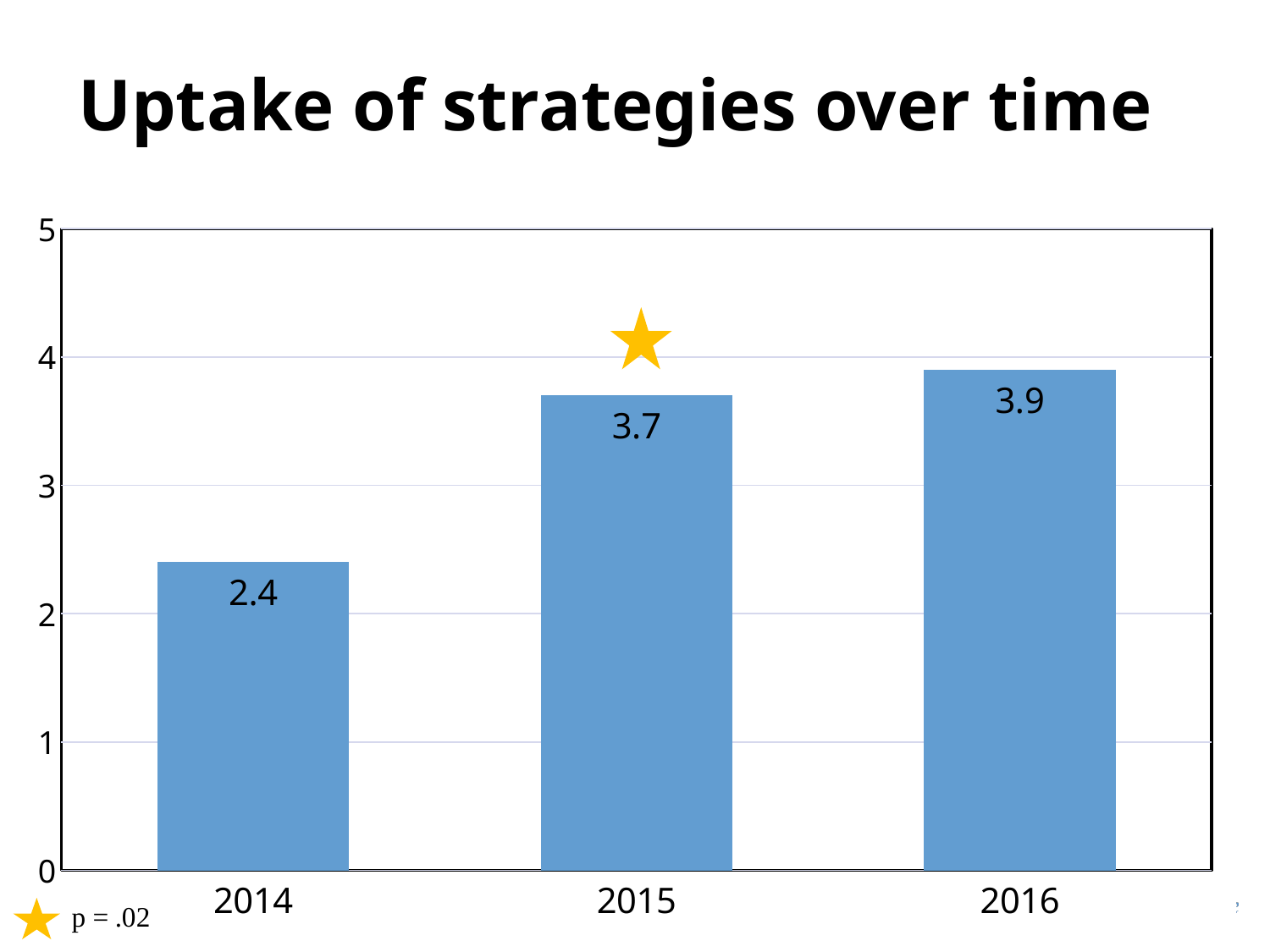
Which is larger, the value for 2014 or the value for 2015? 2015 What kind of chart is this? bar chart Which year has the lowest value? 2014 What is the value for 2016? 3.9 What is the difference between the values for 2016 and 2015? 0.2 Do the values rise or fall from 2014 to 2016? rise How many years are shown on the chart? 3 Which year has the highest value? 2016 Is the value for 2016 greater or less than 3? greater What is the value for 2014? 2.4 What is the difference between the values for 2015 and 2014? 1.3 What is the value for 2015? 3.7